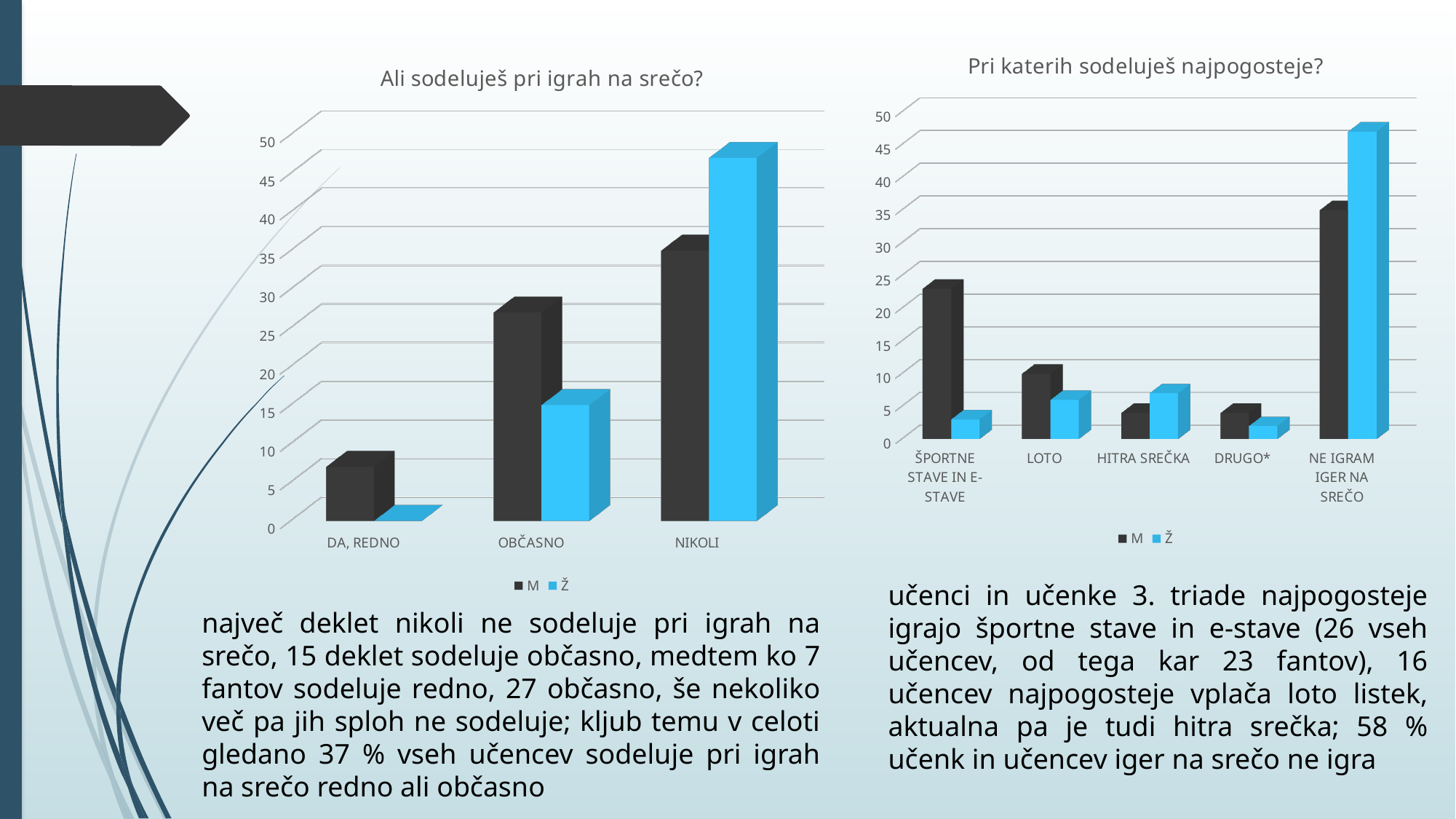
In the chart titled "Pri katerih sodeluješ najpogosteje?", which category has the highest value for the M series? NE IGRAM IGER NA SREČO In the chart titled "Ali sodeluješ pri igrah na srečo?", which series has the larger value for NIKOLI, M or Ž? Ž In the chart titled "Pri katerih sodeluješ najpogosteje?", which series has the larger value for LOTO, M or Ž? M How many series does the legend list in the chart titled "Ali sodeluješ pri igrah na srečo?"? 2 How many categories are shown on the x axis of the chart titled "Pri katerih sodeluješ najpogosteje?"? 5 What are the two legend entries in the chart titled "Pri katerih sodeluješ najpogosteje?"? M and Ž In the chart titled "Pri katerih sodeluješ najpogosteje?", is the value for Ž in ŠPORTNE STAVE IN E-STAVE greater or less than 5? less In the chart titled "Pri katerih sodeluješ najpogosteje?", is the value for M in ŠPORTNE STAVE IN E-STAVE greater or less than 20? greater How many categories are shown on the x axis of the chart titled "Ali sodeluješ pri igrah na srečo?"? 3 In the chart titled "Ali sodeluješ pri igrah na srečo?", which category has the highest value for the Ž series? NIKOLI What kind of chart is the chart titled "Ali sodeluješ pri igrah na srečo?"? bar chart In the chart titled "Ali sodeluješ pri igrah na srečo?", is the value for M in OBČASNO greater or less than 20? greater